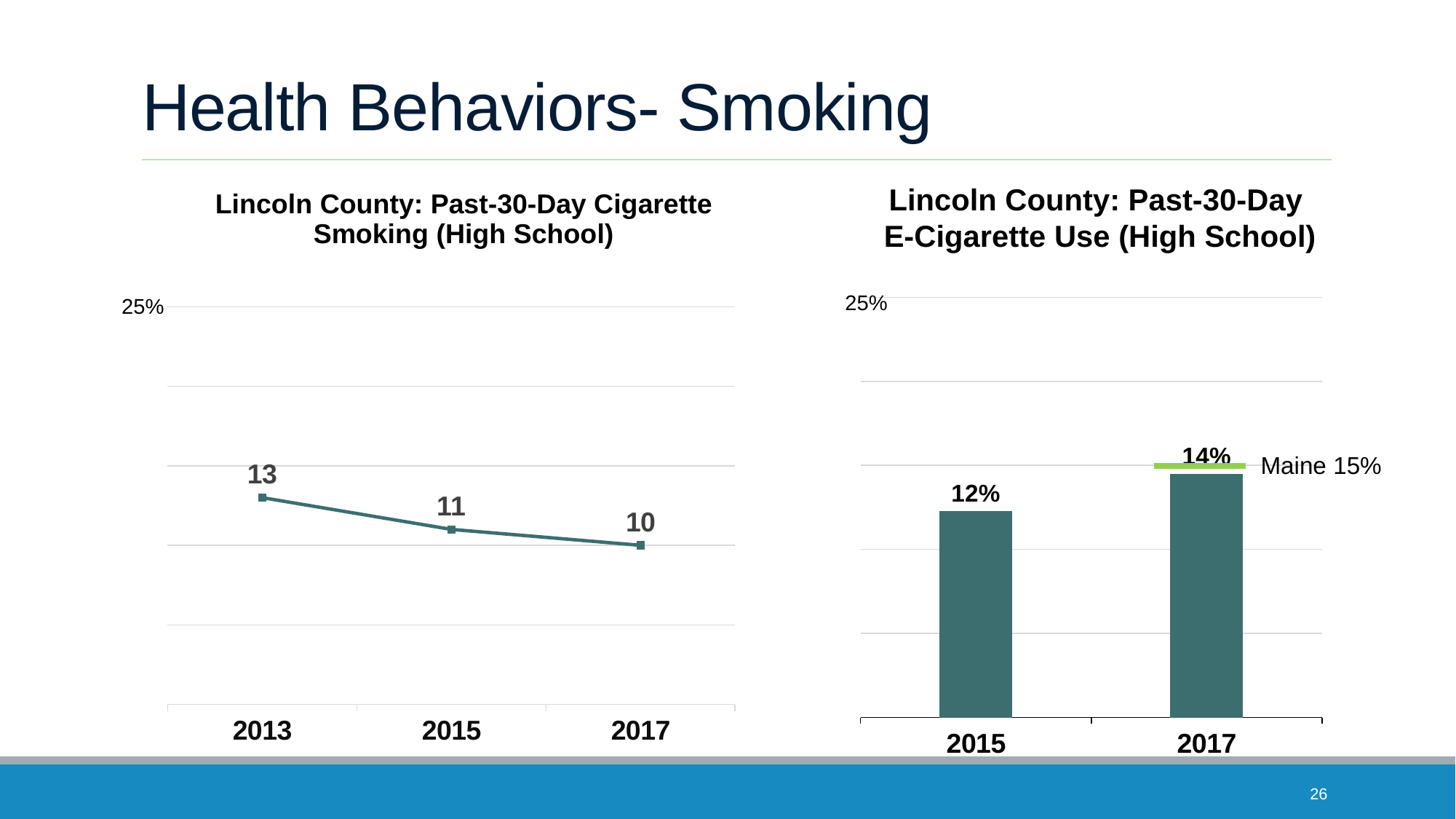
In the 'Lincoln County: Past-30-Day Cigarette Smoking (High School)' chart, do the values rise or fall from 2013 to 2017? fall In the 'Lincoln County: Past-30-Day E-Cigarette Use (High School)' chart, what is the value for 2015? 12% In the 'Lincoln County: Past-30-Day Cigarette Smoking (High School)' chart, which year has the highest value? 2013 In the 'Lincoln County: Past-30-Day Cigarette Smoking (High School)' chart, what is the value for 2013? 13 In the 'Lincoln County: Past-30-Day Cigarette Smoking (High School)' chart, what is the difference between the 2013 and 2017 values? 3 In the 'Lincoln County: Past-30-Day E-Cigarette Use (High School)' chart, which year has the larger value, 2015 or 2017? 2017 What kind of chart is the 'Lincoln County: Past-30-Day E-Cigarette Use (High School)' chart? bar chart In the 'Lincoln County: Past-30-Day E-Cigarette Use (High School)' chart, what is the value for 2017? 14% In the 'Lincoln County: Past-30-Day Cigarette Smoking (High School)' chart, what is the value for 2017? 10 In the 'Lincoln County: Past-30-Day E-Cigarette Use (High School)' chart, what Maine value is marked by the green reference line? Maine 15% What kind of chart is the 'Lincoln County: Past-30-Day Cigarette Smoking (High School)' chart? line chart How many data points are plotted in the 'Lincoln County: Past-30-Day Cigarette Smoking (High School)' chart? 3